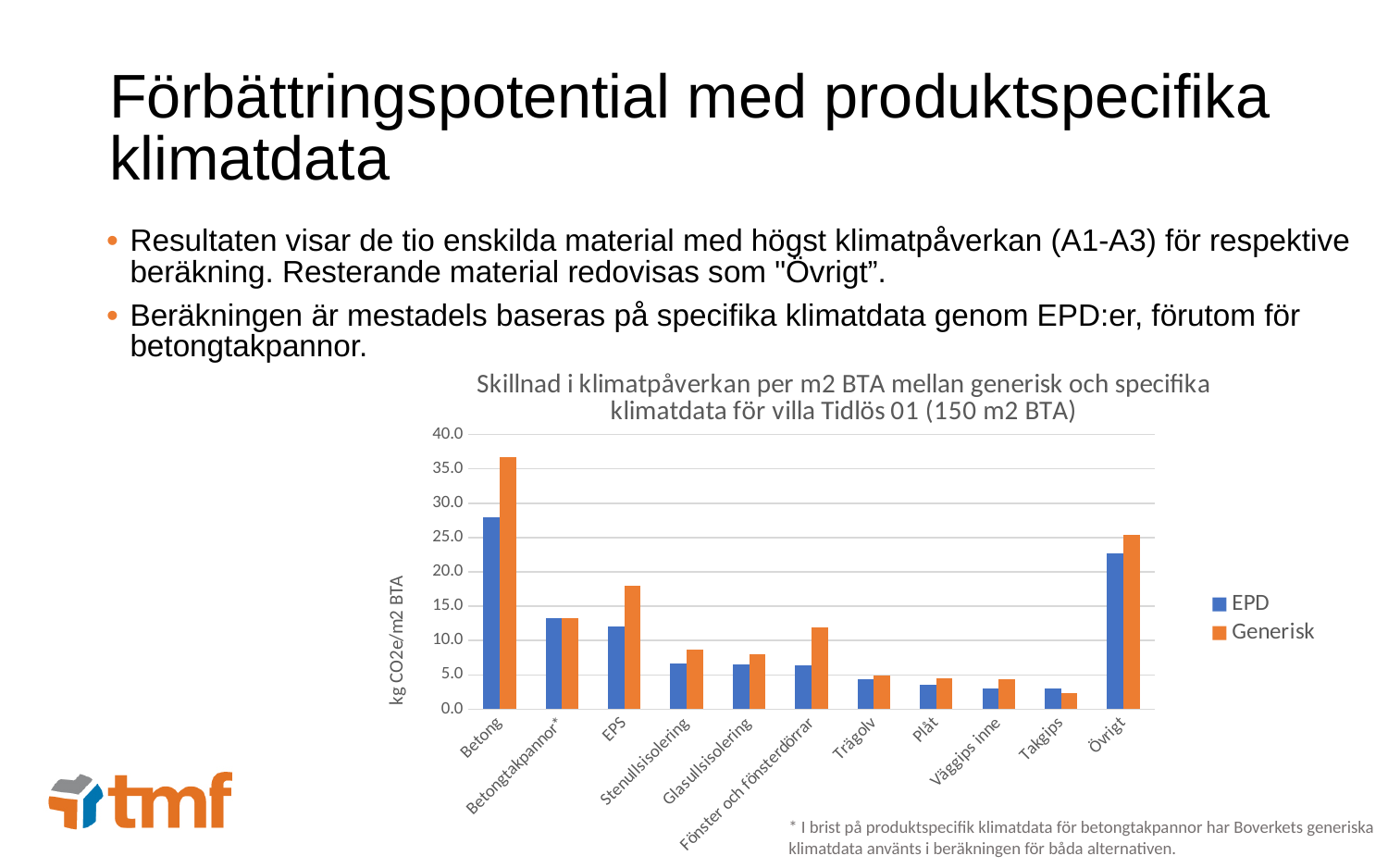
Is the EPD value for Övrigt greater or less than 20.0? greater Which category has the lowest Generisk value? Takgips Is the Generisk value for Fönster och fönsterdörrar greater or less than 10.0? greater Is the Generisk value for Betong greater or less than 35.0? greater Which category has the highest Generisk value? Betong For Takgips, which series has the larger value, EPD or Generisk? EPD How many series does the chart legend list? 2 For Betong, which series has the larger value, EPD or Generisk? Generisk What kind of chart is shown on the slide? bar chart How many categories are shown on the x axis of the chart? 11 What is the label on the y axis of the chart? kg CO2e/m2 BTA